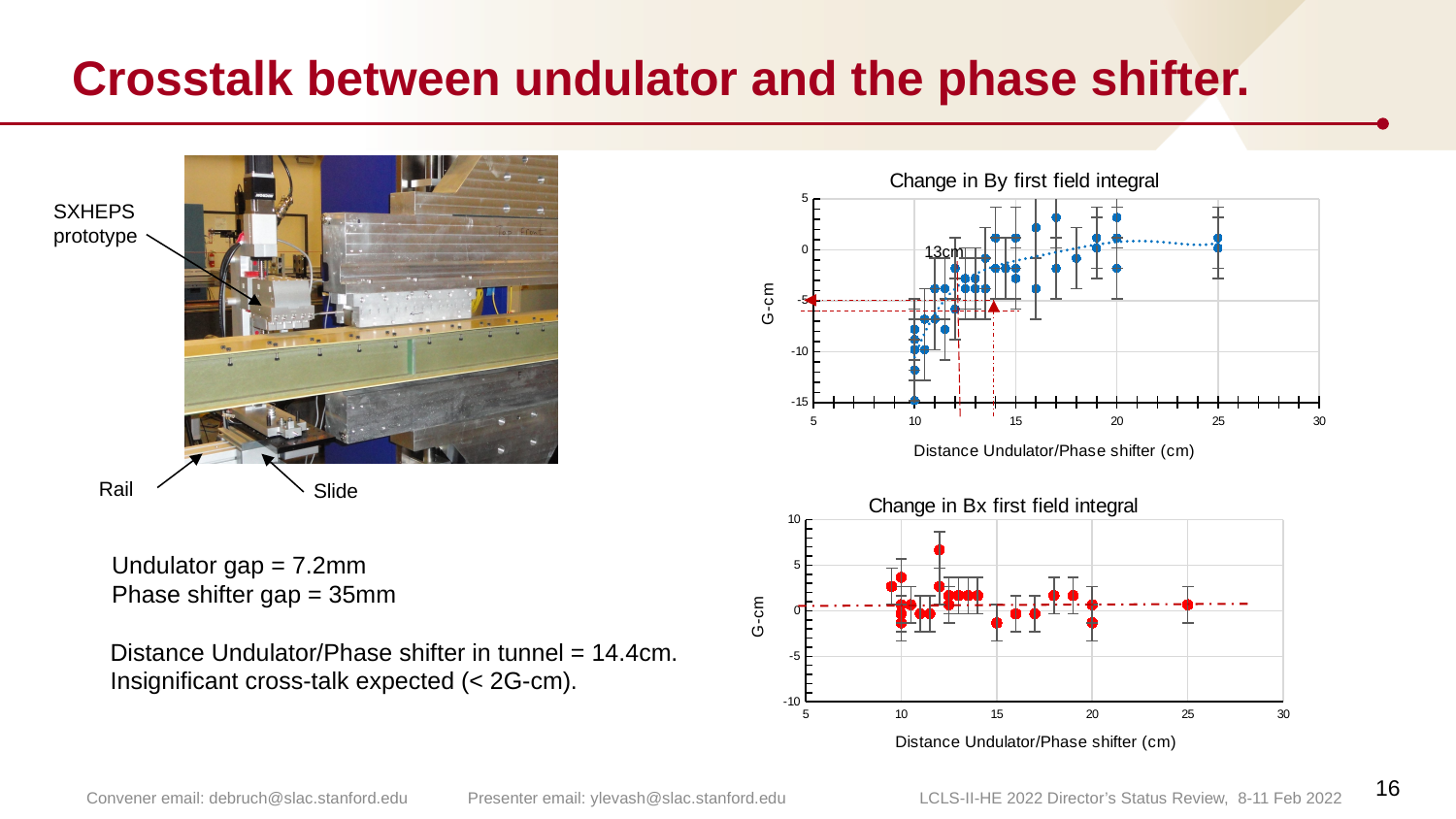
How many charts are shown on the slide? 2 What is the title of the top chart on the slide? Change in By first field integral What is the maximum value shown on the x axis of the 'Change in By first field integral' chart? 30 In the 'Change in By first field integral' chart, is the value at a distance of 25 cm larger or smaller than the lowest value at a distance of 10 cm? larger What kind of chart is the 'Change in Bx first field integral' chart? scatter chart What kind of chart is the 'Change in By first field integral' chart? scatter chart In the 'Change in Bx first field integral' chart, is the value at a distance of 25 cm greater or less than 5 G-cm? less What is the x-axis label of the 'Change in Bx first field integral' chart? Distance Undulator/Phase shifter (cm) In the 'Change in By first field integral' chart, is the lowest value plotted at a distance of 10 cm greater or less than -10 G-cm? less In the 'Change in Bx first field integral' chart, is the highest plotted value greater or less than 5 G-cm? greater In the 'Change in By first field integral' chart, do the values generally rise or fall as the distance increases along the x axis? rise